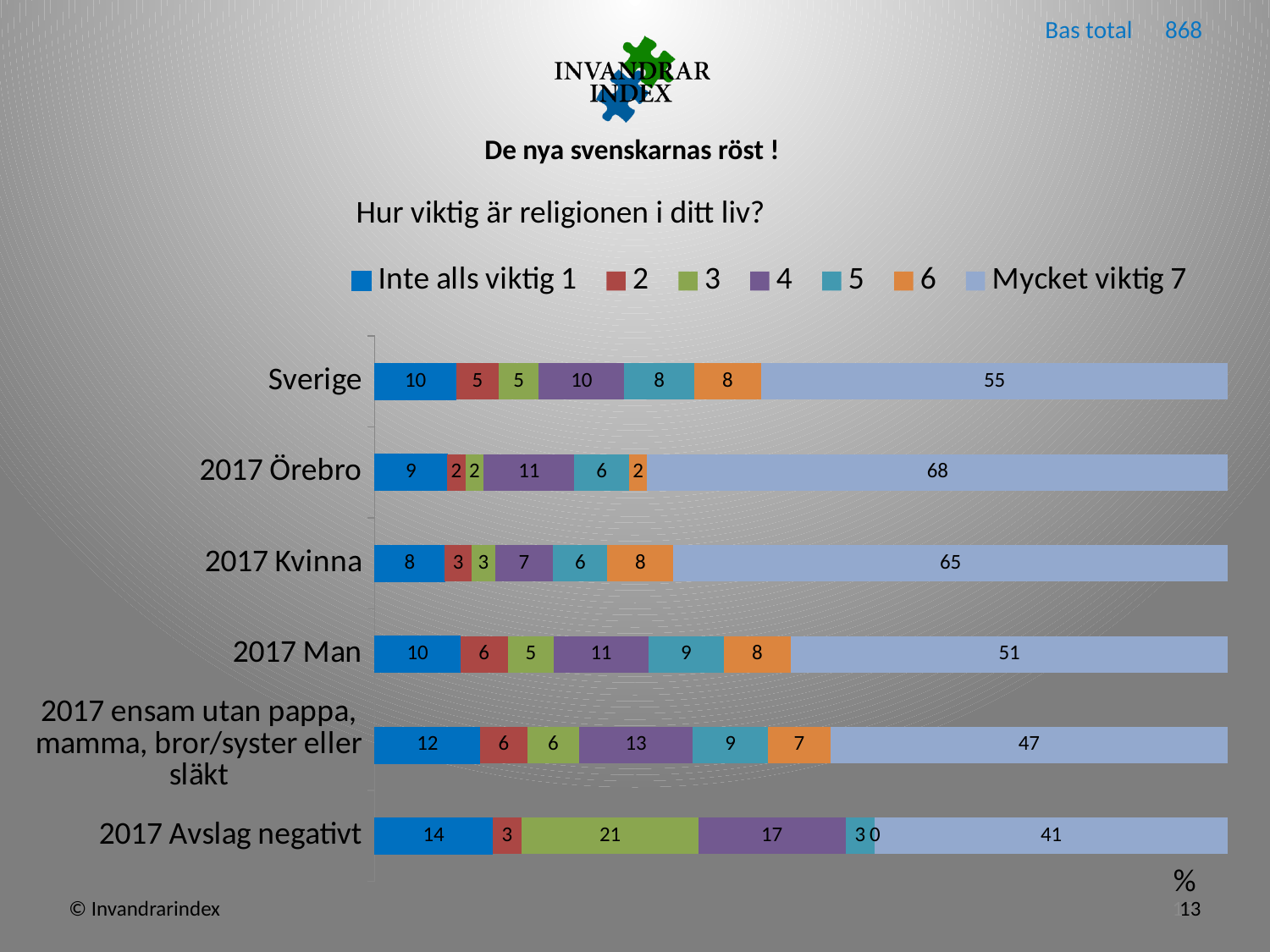
What is the total of the stacked bar for 2017 Örebro? 100 Which category has the highest value for "Mycket viktig 7"? 2017 Örebro How many series does the legend list? 7 How many categories are shown on the chart? 6 What is the value for "Inte alls viktig 1" for 2017 Avslag negativt? 14 Which category has the lowest value for "Mycket viktig 7"? 2017 Avslag negativt What is the difference between the "Mycket viktig 7" values for 2017 Kvinna and 2017 Man? 14 Which has a larger "Inte alls viktig 1" value, 2017 Kvinna or 2017 Man? 2017 Man What is the value for series "4" for 2017 ensam utan pappa, mamma, bror/syster eller släkt? 13 What is the value for "Mycket viktig 7" for Sverige? 55 What kind of chart is shown on the slide? Stacked bar chart What is the value for series "3" for 2017 Avslag negativt? 21